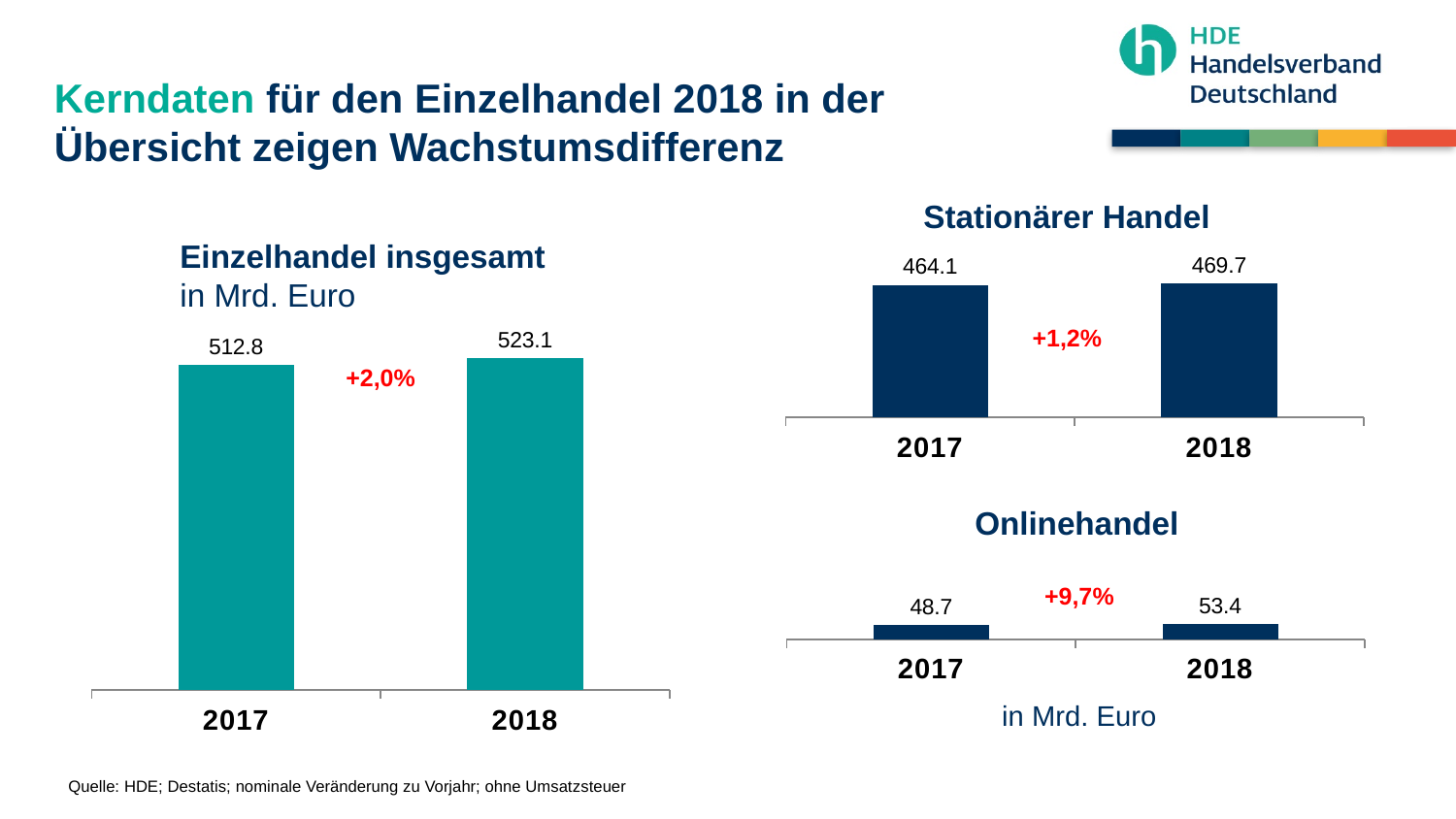
In the 'Stationärer Handel' chart, which year has the higher value? 2018 In the 'Einzelhandel insgesamt' chart, what is the difference between the 2018 and 2017 values? 10.3 In the 'Stationärer Handel' chart, what is the value for 2017? 464.1 In the 'Stationärer Handel' chart, is the value for 2018 larger or smaller than the value for 2017? larger In the 'Onlinehandel' chart, which year has the lower value? 2017 How many bars are shown in the 'Onlinehandel' chart? 2 What kind of chart is the 'Einzelhandel insgesamt' chart? bar chart In the 'Onlinehandel' chart, what is the difference between the 2018 and 2017 values? 4.7 What percentage change is printed between the bars in the 'Onlinehandel' chart? +9,7% In the 'Einzelhandel insgesamt' chart, what is the value for 2017? 512.8 In the 'Einzelhandel insgesamt' chart, what is the value for 2018? 523.1 In the 'Onlinehandel' chart, what is the value for 2018? 53.4